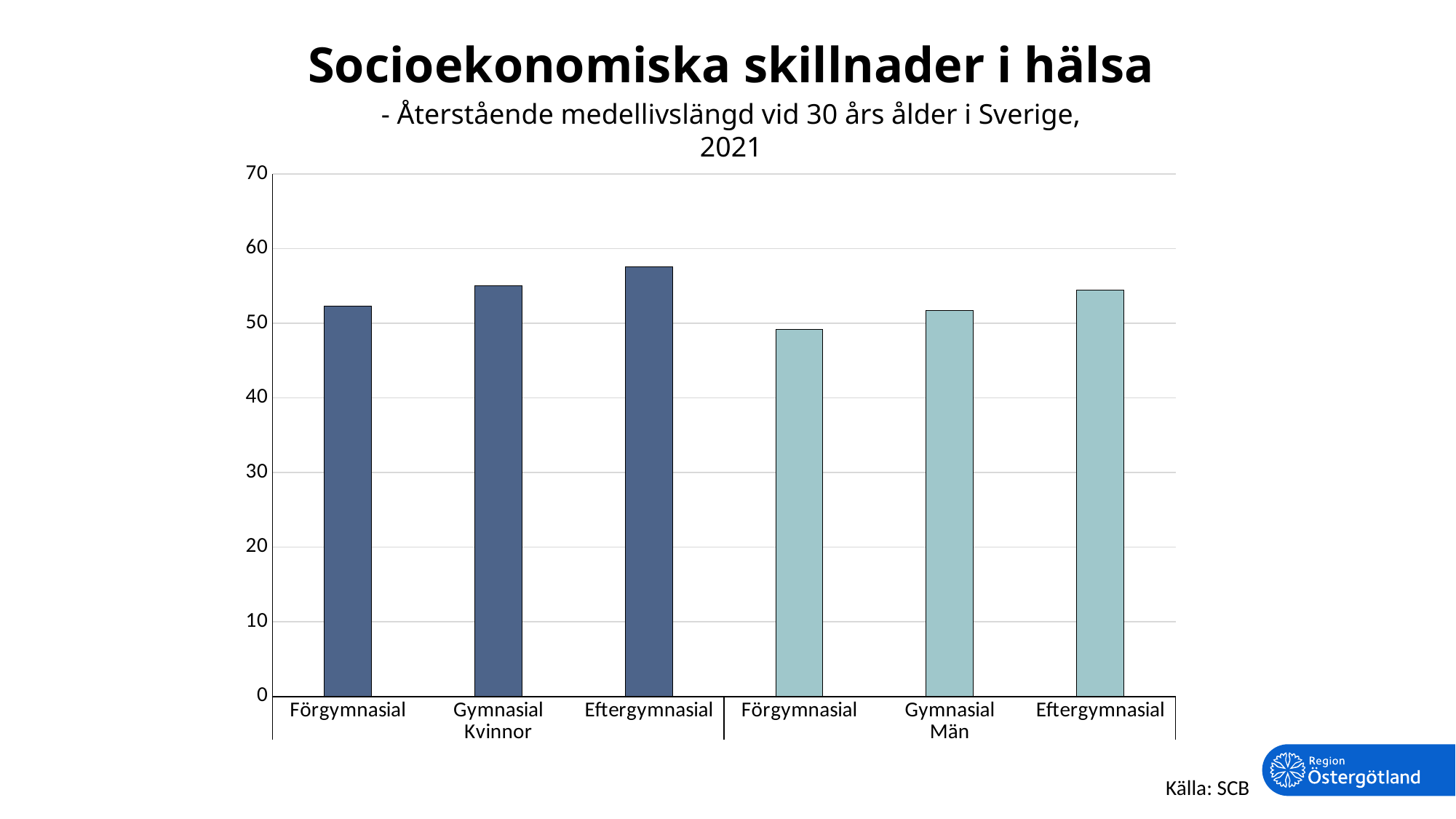
Is the value for Förgymnasial among Män greater or less than 40? greater Is the value for Eftergymnasial among Kvinnor greater or less than 50? greater Which bar has the lowest value in the chart? Förgymnasial (Män) Is the value for Gymnasial among Kvinnor greater or less than 50? greater Which is larger: the value for Förgymnasial among Kvinnor or Förgymnasial among Män? Förgymnasial among Kvinnor Which bar has the highest value in the chart? Eftergymnasial (Kvinnor) What source is cited for the chart data? SCB Within each group (Kvinnor and Män), do the values rise or fall from Förgymnasial to Eftergymnasial? Rise What kind of chart is shown on the slide? Bar chart How many bars are plotted in the chart? 6 Which is larger: the value for Eftergymnasial among Kvinnor or Eftergymnasial among Män? Eftergymnasial among Kvinnor